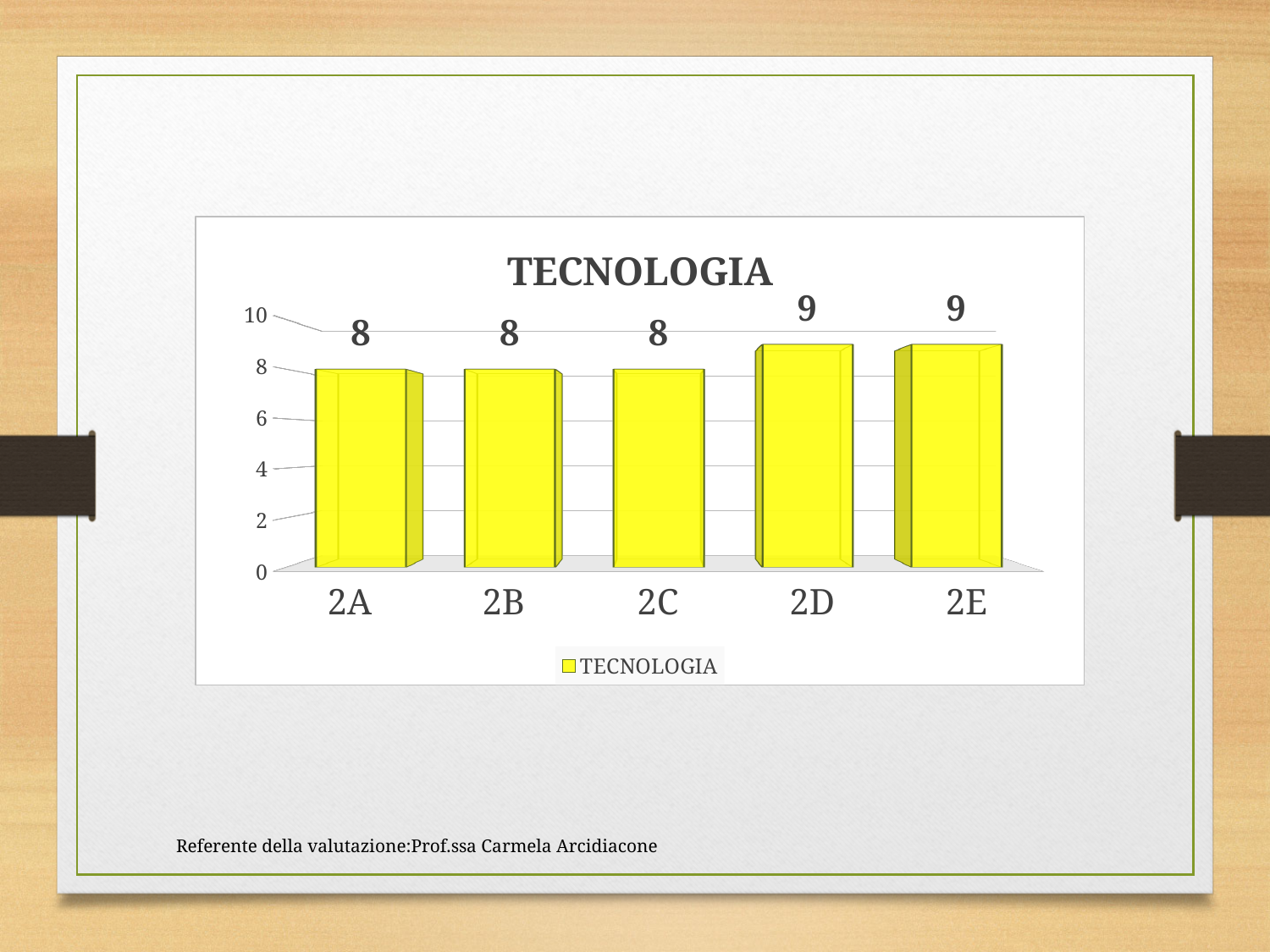
What is the title of the chart? TECNOLOGIA Which is larger, the value for 2D or the value for 2A? 2D What is the value for 2D? 9 How many series does the legend list? 1 Is the value for 2B greater or less than 10? less What colour are the bars? yellow What is the value for 2C? 8 What is the value for 2A? 8 What kind of chart is shown? bar chart How many categories are shown on the x axis? 5 What is the difference between the values for 2E and 2B? 1 What is the lowest value shown in the chart? 8